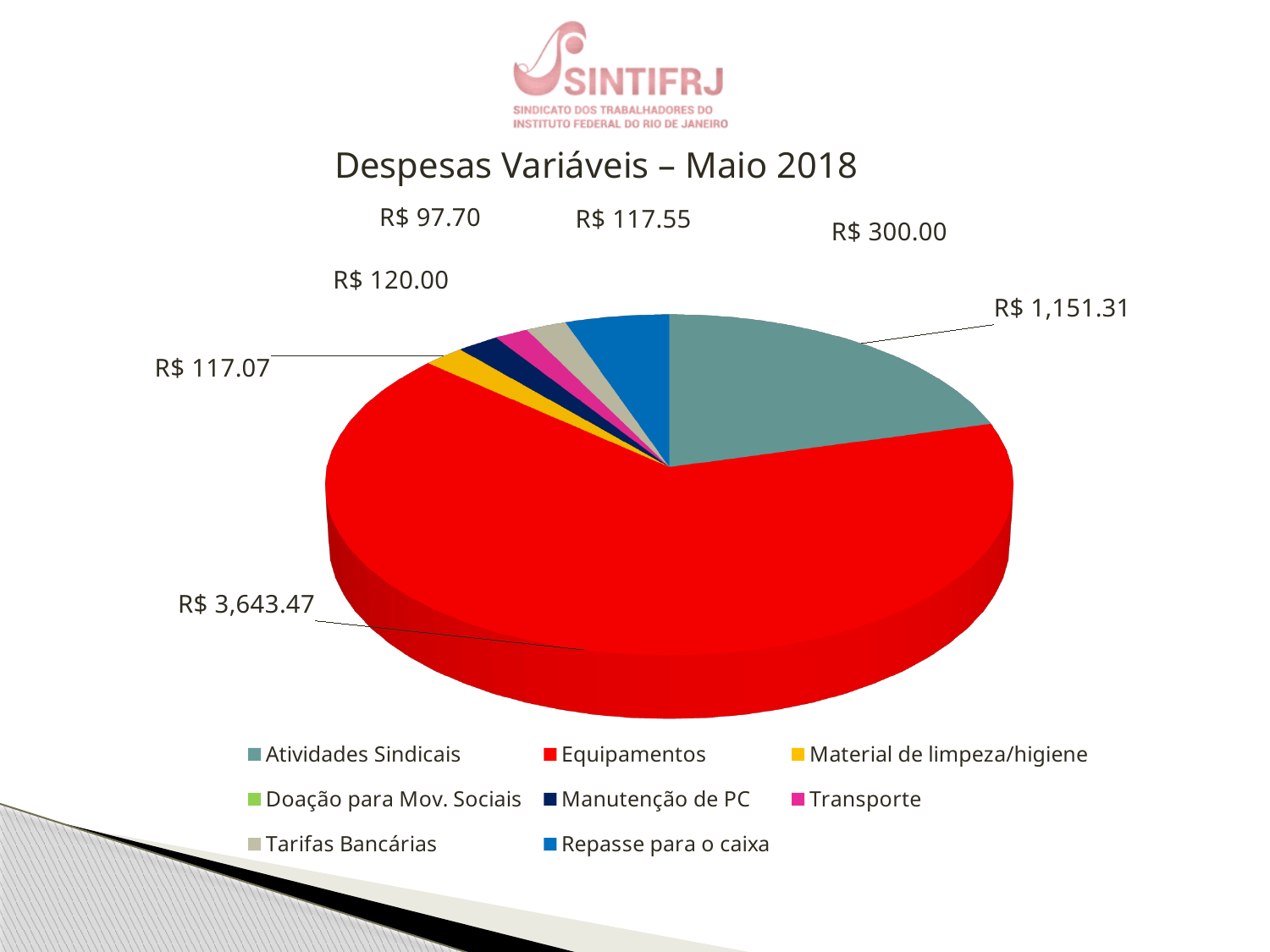
Which category has the largest slice of the pie? Equipamentos What is the difference between the values for Equipamentos and Atividades Sindicais? R$ 2,492.16 What is the title of the chart? Despesas Variáveis – Maio 2018 What kind of chart is shown on the slide? pie chart What is the value shown for Material de limpeza/higiene? R$ 117.07 How many categories does the legend list? 8 What is the value shown for Atividades Sindicais? R$ 1,151.31 Which is larger, the value for Atividades Sindicais or the value for Repasse para o caixa? Atividades Sindicais What is the smallest value printed on the chart? R$ 97.70 What is the difference between the values for Atividades Sindicais and Repasse para o caixa? R$ 851.31 What is the value shown for Equipamentos? R$ 3,643.47 What is the value shown for Repasse para o caixa? R$ 300.00